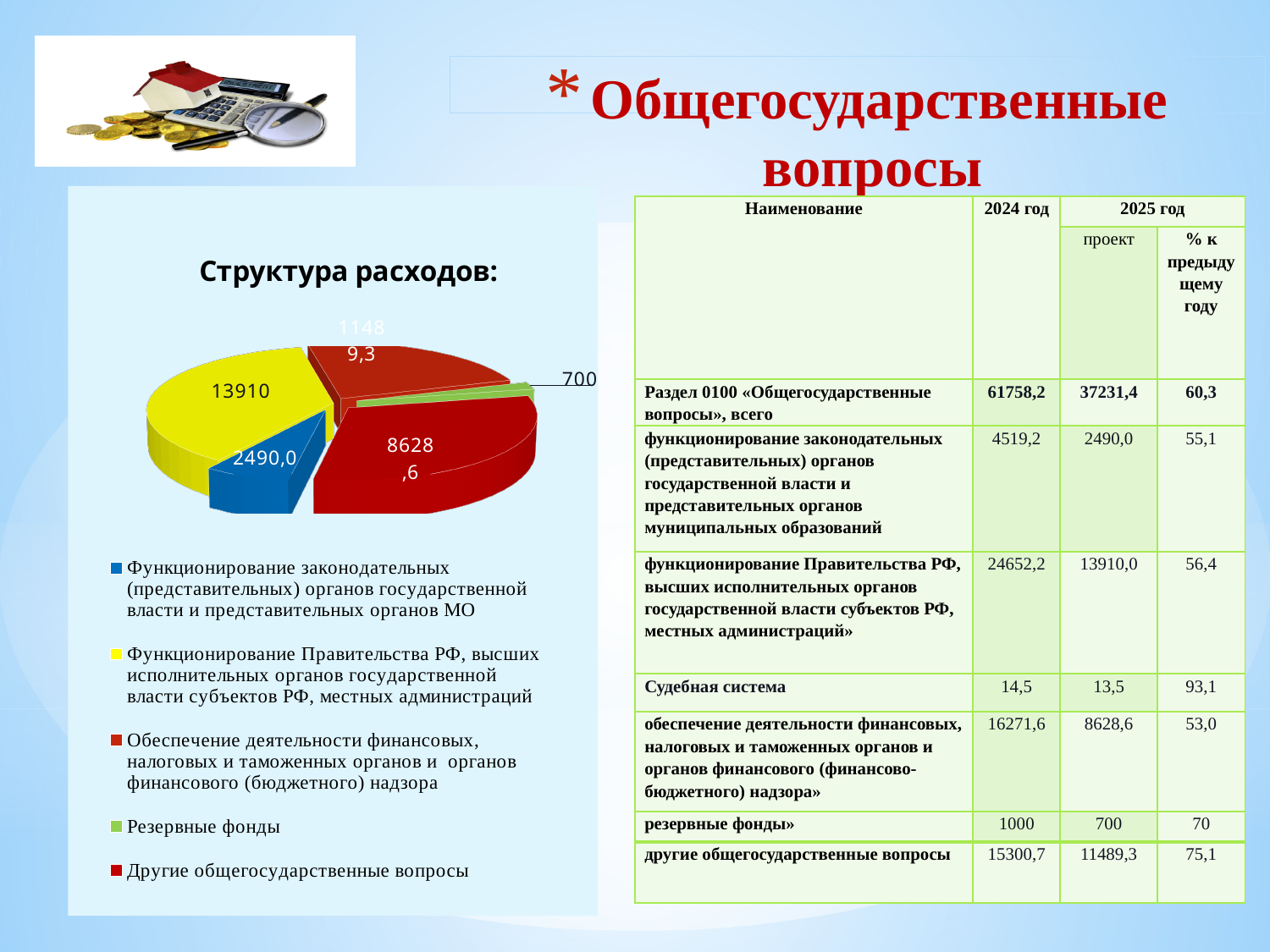
What is the value for Резервные фонды in the pie chart? 700 How many entries does the legend of the pie chart list? 5 What kind of chart is shown on the slide? pie chart What is the value for Обеспечение деятельности финансовых, налоговых и таможенных органов и органов финансового (бюджетного) надзора in the pie chart? 8628,6 What is the value for Функционирование законодательных (представительных) органов государственной власти и представительных органов МО in the pie chart? 2490,0 What is the value for Функционирование Правительства РФ, высших исполнительных органов государственной власти субъектов РФ, местных администраций in the pie chart? 13910 How many slices does the pie chart have? 5 Which category has the smallest slice in the pie chart? Резервные фонды What is the difference between the value for Функционирование Правительства РФ (13910) and the value for Обеспечение деятельности финансовых, налоговых и таможенных органов (8628,6)? 5281,4 Which category has the largest slice in the pie chart? Функционирование Правительства РФ, высших исполнительных органов государственной власти субъектов РФ, местных администраций Which is larger in the pie chart: Функционирование Правительства РФ or Обеспечение деятельности финансовых, налоговых и таможенных органов? Функционирование Правительства РФ What is the title of the pie chart? Структура расходов: